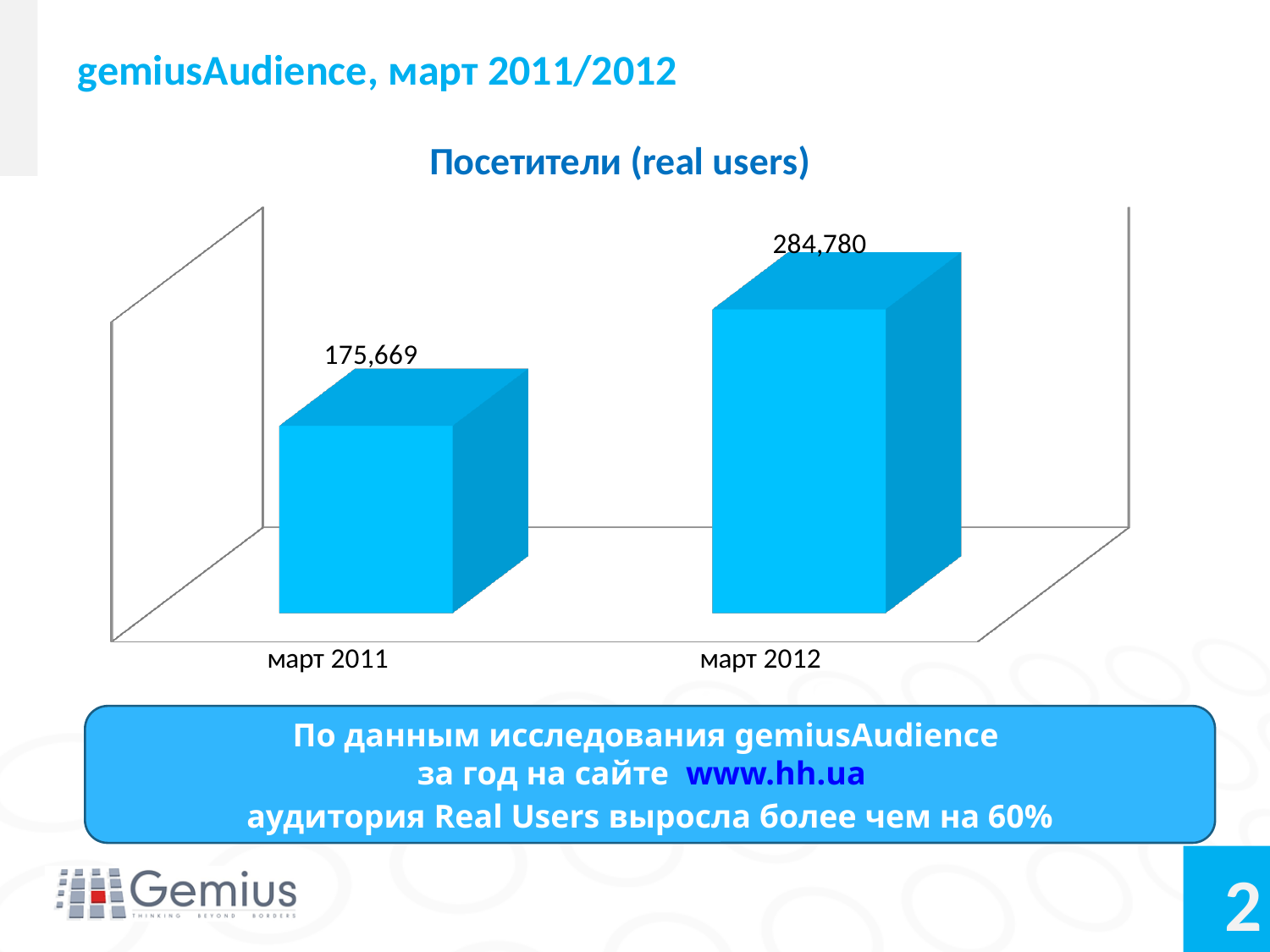
Which is larger, the value for март 2011 or март 2012? март 2012 What is the difference between the values for март 2012 and март 2011? 109,111 Do the values rise or fall from март 2011 to март 2012? rise Which category has the lowest value? март 2011 What is the value for март 2012? 284,780 What is the value for март 2011? 175,669 How many categories are shown in the chart? 2 What kind of chart is shown on the slide? bar chart What is the title of the chart? Посетители (real users) Which category has the highest value? март 2012 What colour are the bars in the chart? blue